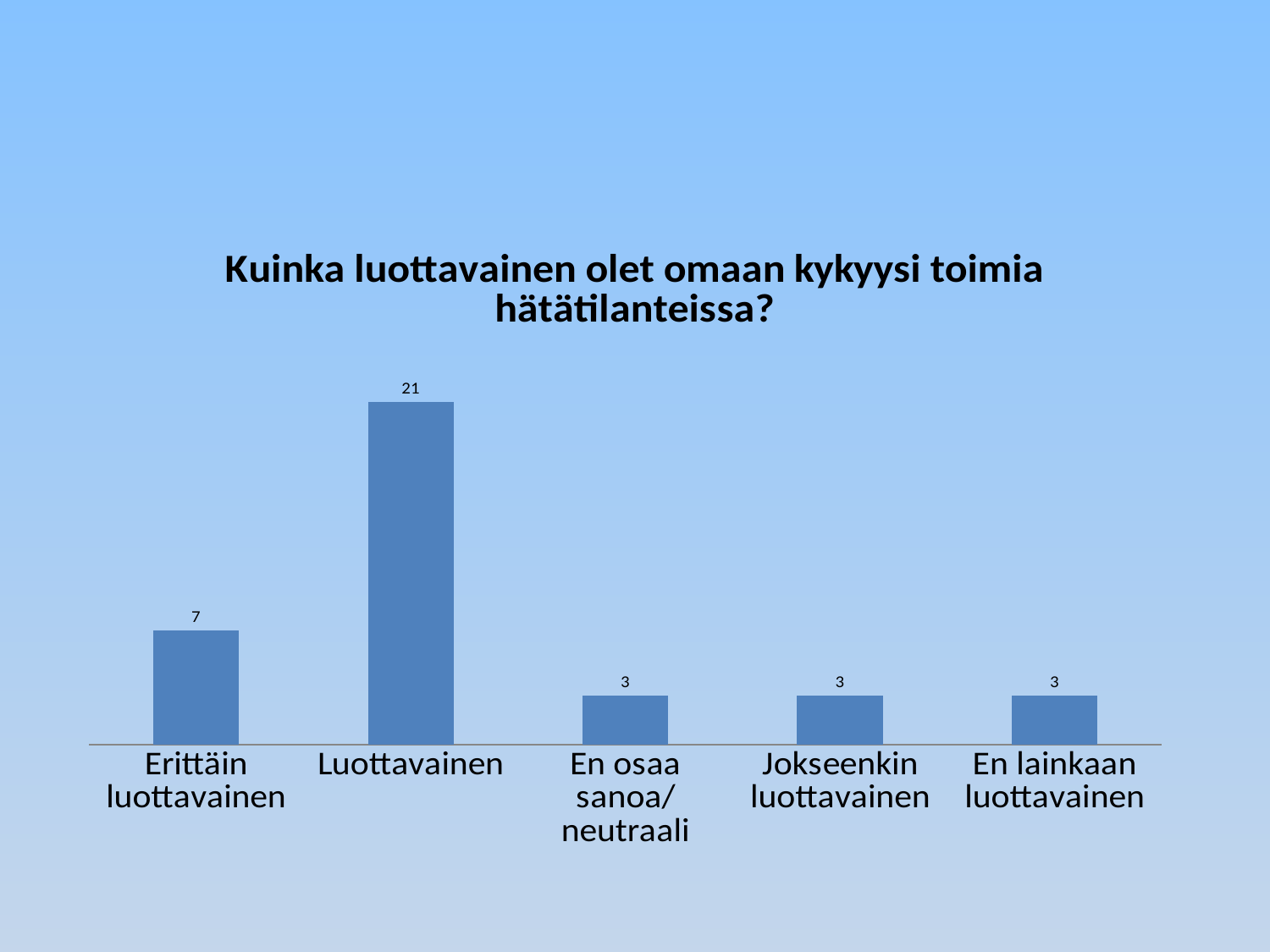
How many categories have a value of 3? 3 What is the value for "En osaa sanoa/neutraali"? 3 What is the difference between the values for "Luottavainen" and "Erittäin luottavainen"? 14 What is the value for "En lainkaan luottavainen"? 3 How many categories are shown on the x axis? 5 What is the value for "Luottavainen"? 21 What is the value for "Erittäin luottavainen"? 7 What is the title of the chart? Kuinka luottavainen olet omaan kykyysi toimia hätätilanteissa? Which category has the highest value? Luottavainen Which is larger, the value for "Erittäin luottavainen" or the value for "Jokseenkin luottavainen"? Erittäin luottavainen What is the difference between the values for "Erittäin luottavainen" and "Jokseenkin luottavainen"? 4 What kind of chart is shown on the slide? Bar chart